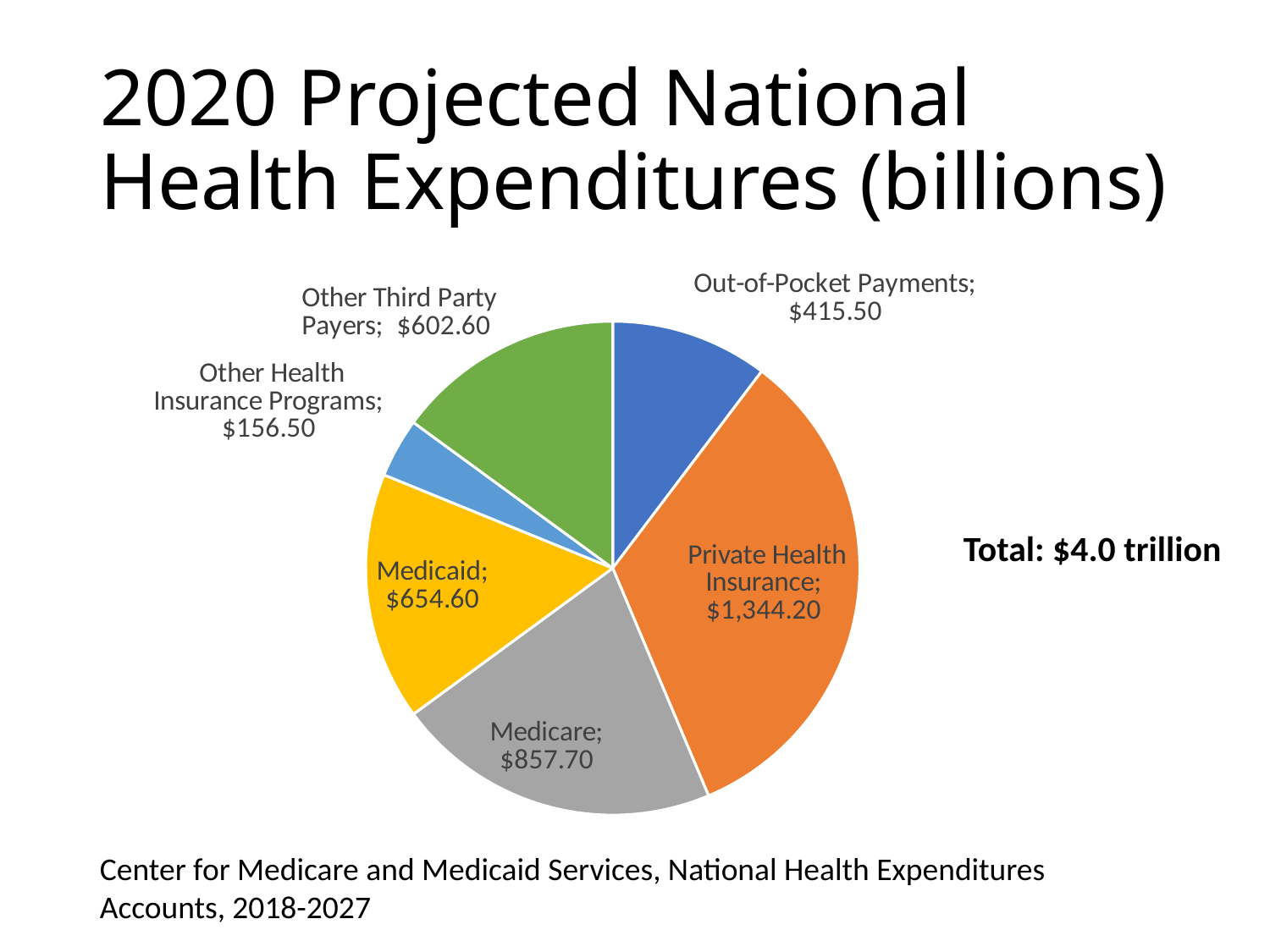
What is the value for Private Health Insurance? $1,344.20 Which is larger, Other Third Party Payers or Out-of-Pocket Payments? Other Third Party Payers What is the value for Out-of-Pocket Payments? $415.50 How many categories are shown in the pie chart? 6 What is the value for Medicare? $857.70 What kind of chart is shown on the slide? Pie chart Which category has the largest slice? Private Health Insurance What total is stated next to the chart? $4.0 trillion What is the difference between Private Health Insurance and Medicare? $486.50 What is the difference between Medicare and Medicaid? $203.10 What is the value for Other Health Insurance Programs? $156.50 Which category has the smallest slice? Other Health Insurance Programs